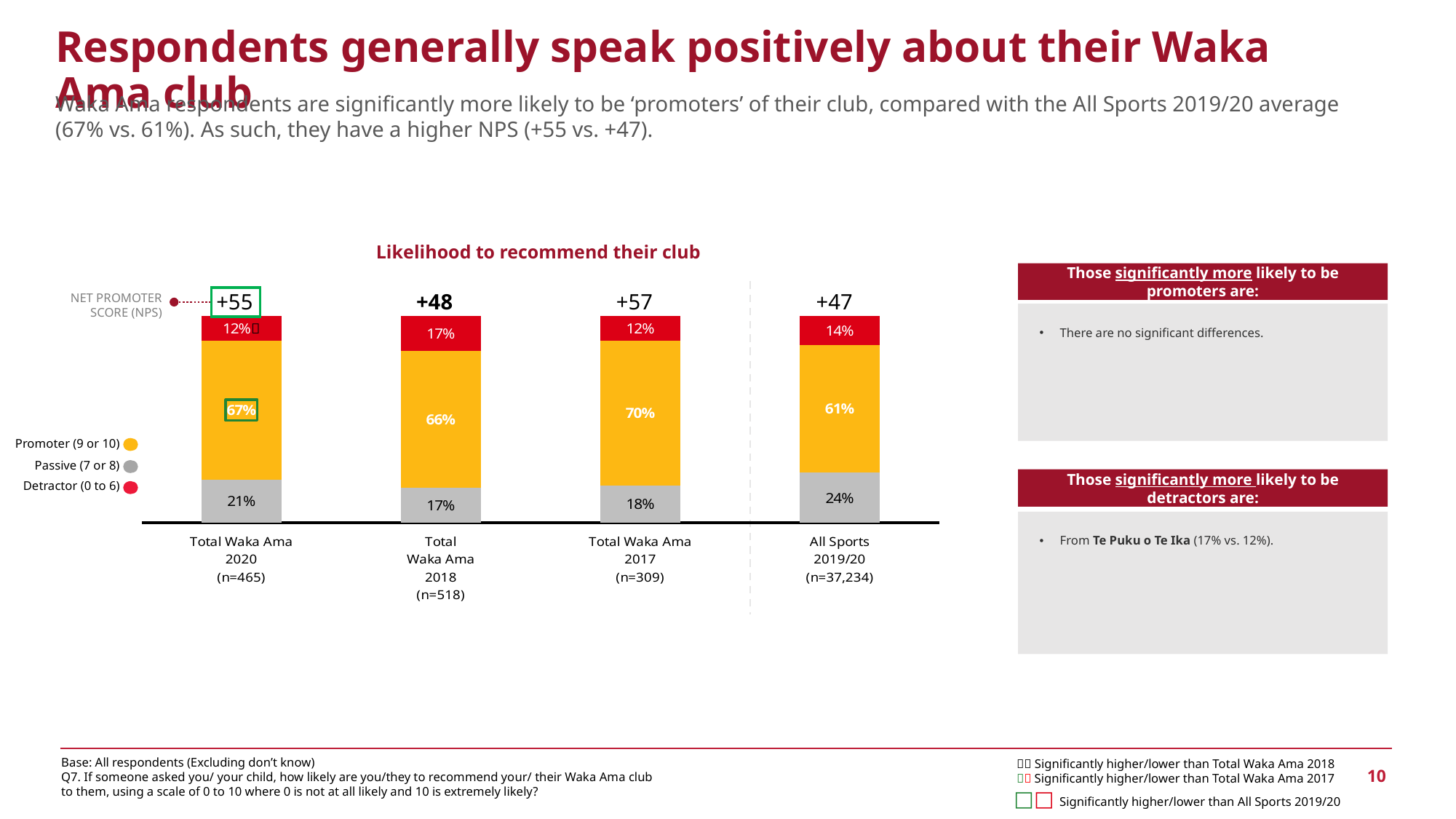
Which category has the highest Promoter (9 or 10) percentage? Total Waka Ama 2017 How many bars (categories) are shown in the chart? 4 What percentage of All Sports 2019/20 respondents are Passive (7 or 8)? 24% What percentage of Total Waka Ama 2020 respondents are Promoters (9 or 10)? 67% Which category has the lowest Net Promoter Score (NPS)? All Sports 2019/20 What percentage of Total Waka Ama 2017 respondents are Detractors (0 to 6)? 12% What is the title of the chart? Likelihood to recommend their club Which has a higher Detractor (0 to 6) percentage, Total Waka Ama 2018 or All Sports 2019/20? Total Waka Ama 2018 What type of chart is used to show likelihood to recommend their club? Stacked bar chart What is the Net Promoter Score (NPS) shown for Total Waka Ama 2018? +48 What is the difference in Promoter (9 or 10) percentage between Total Waka Ama 2020 and All Sports 2019/20? 6 percentage points How many series does the legend list? 3